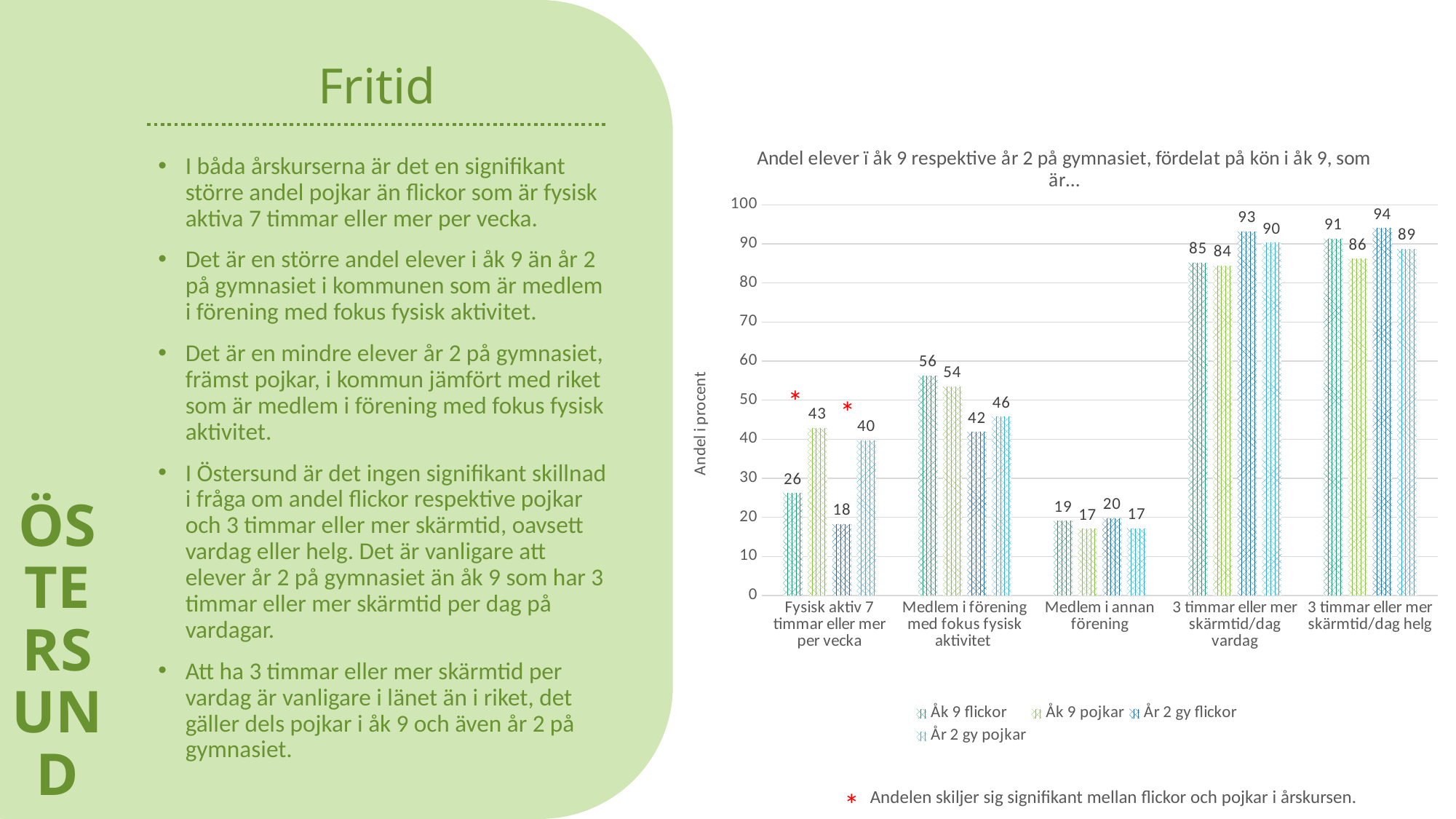
Which series has the highest value in the category '3 timmar eller mer skärmtid/dag vardag'? År 2 gy flickor What is the label of the y axis of the chart? Andel i procent What is the difference between Åk 9 pojkar and Åk 9 flickor in the category 'Fysisk aktiv 7 timmar eller mer per vecka'? 17 Which series has the lowest value in the category 'Fysisk aktiv 7 timmar eller mer per vecka'? År 2 gy flickor What is the value for År 2 gy pojkar in the category '3 timmar eller mer skärmtid/dag helg'? 89 What type of chart is shown on the slide? bar chart What is the value for År 2 gy flickor in the category 'Medlem i förening med fokus fysisk aktivitet'? 42 Which is larger in the category 'Medlem i förening med fokus fysisk aktivitet': Åk 9 flickor or År 2 gy pojkar? Åk 9 flickor What is the value for Åk 9 pojkar in the category 'Fysisk aktiv 7 timmar eller mer per vecka'? 43 How many series does the chart legend list? 4 What is the value for År 2 gy flickor in the category 'Medlem i annan förening'? 20 How many categories are shown on the x axis of the chart? 5